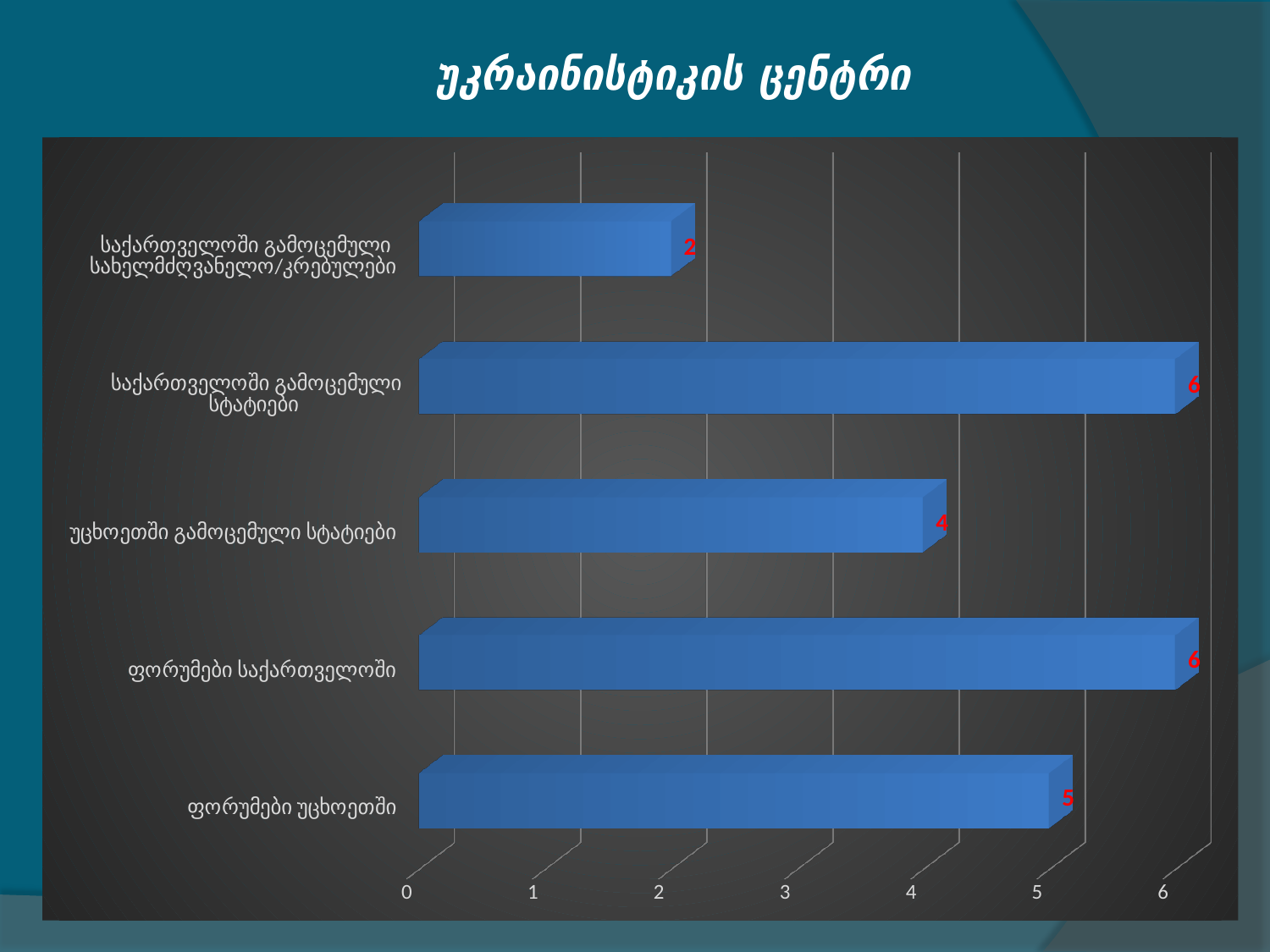
What is the value for საქართველოში გამოცემული სახელმძღვანელო/კრებულები? 2 Which is larger: the value for უცხოეთში გამოცემული სტატიები or the value for ფორუმები უცხოეთში? ფორუმები უცხოეთში What is the difference between the values for ფორუმები საქართველოში and ფორუმები უცხოეთში? 1 Is the value for საქართველოში გამოცემული სტატიები greater or less than 3? greater What is the title of the slide? უკრაინისტიკის ცენტრი What is the value for ფორუმები უცხოეთში? 5 What is the difference between the values for საქართველოში გამოცემული სტატიები and უცხოეთში გამოცემული სტატიები? 2 Which category has the lowest value? საქართველოში გამოცემული სახელმძღვანელო/კრებულები What is the value for უცხოეთში გამოცემული სტატიები? 4 How many categories are shown in the chart? 5 What kind of chart is shown on the slide? bar chart What is the value for ფორუმები საქართველოში? 6